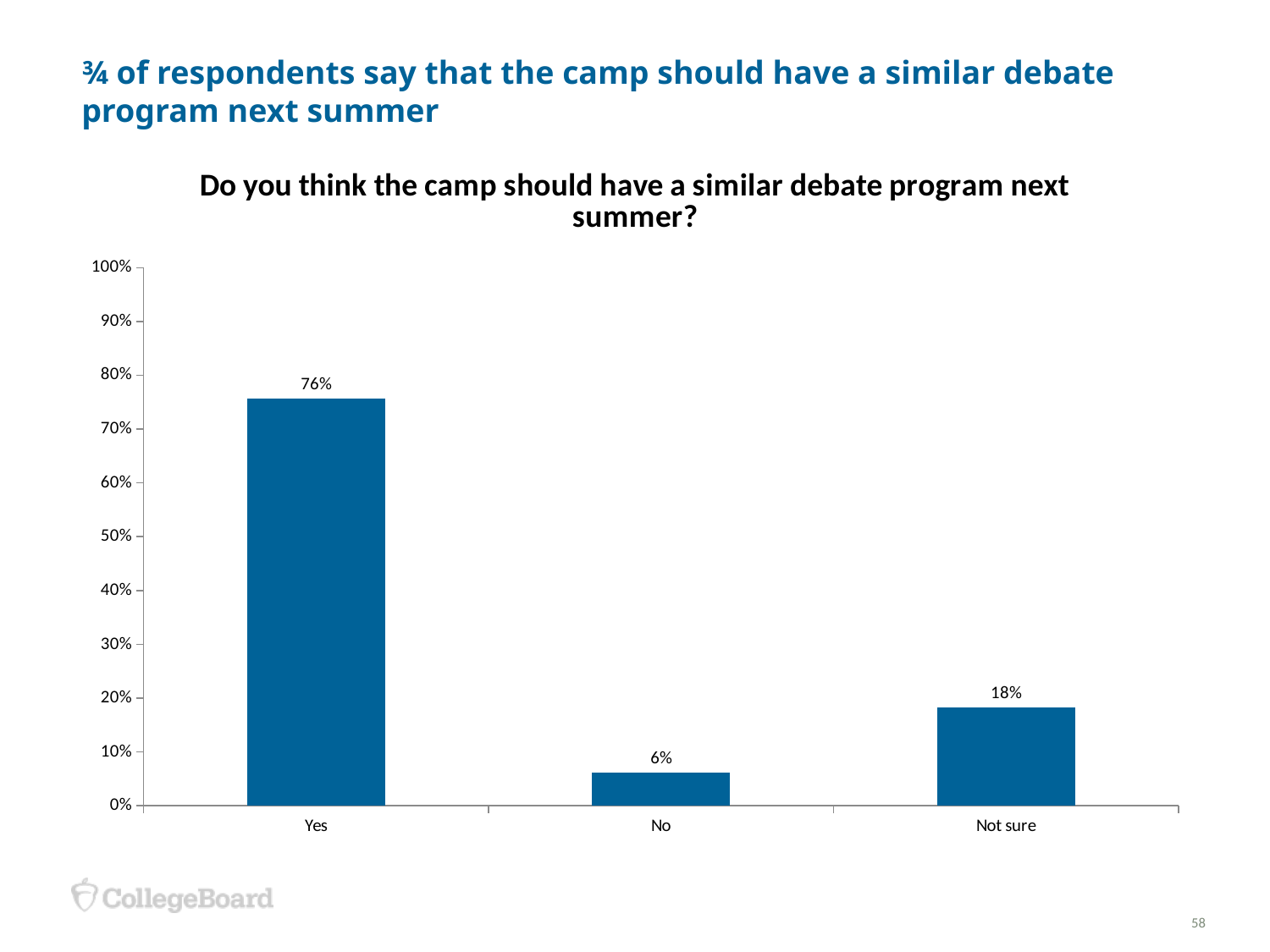
What is the difference between the "Not sure" and "No" percentages? 12% What is the difference between the "Yes" and "Not sure" percentages? 58% Which response category has the lowest value? No Is the value for "Yes" greater or less than 70%? greater Which is larger, the value for "No" or the value for "Not sure"? Not sure What percentage of respondents answered "No"? 6% How many response categories are shown on the x axis? 3 What kind of chart is shown on the slide? Bar chart What is the title of the chart? Do you think the camp should have a similar debate program next summer? Which response category has the highest value? Yes What percentage of respondents answered "Yes"? 76% What percentage of respondents answered "Not sure"? 18%